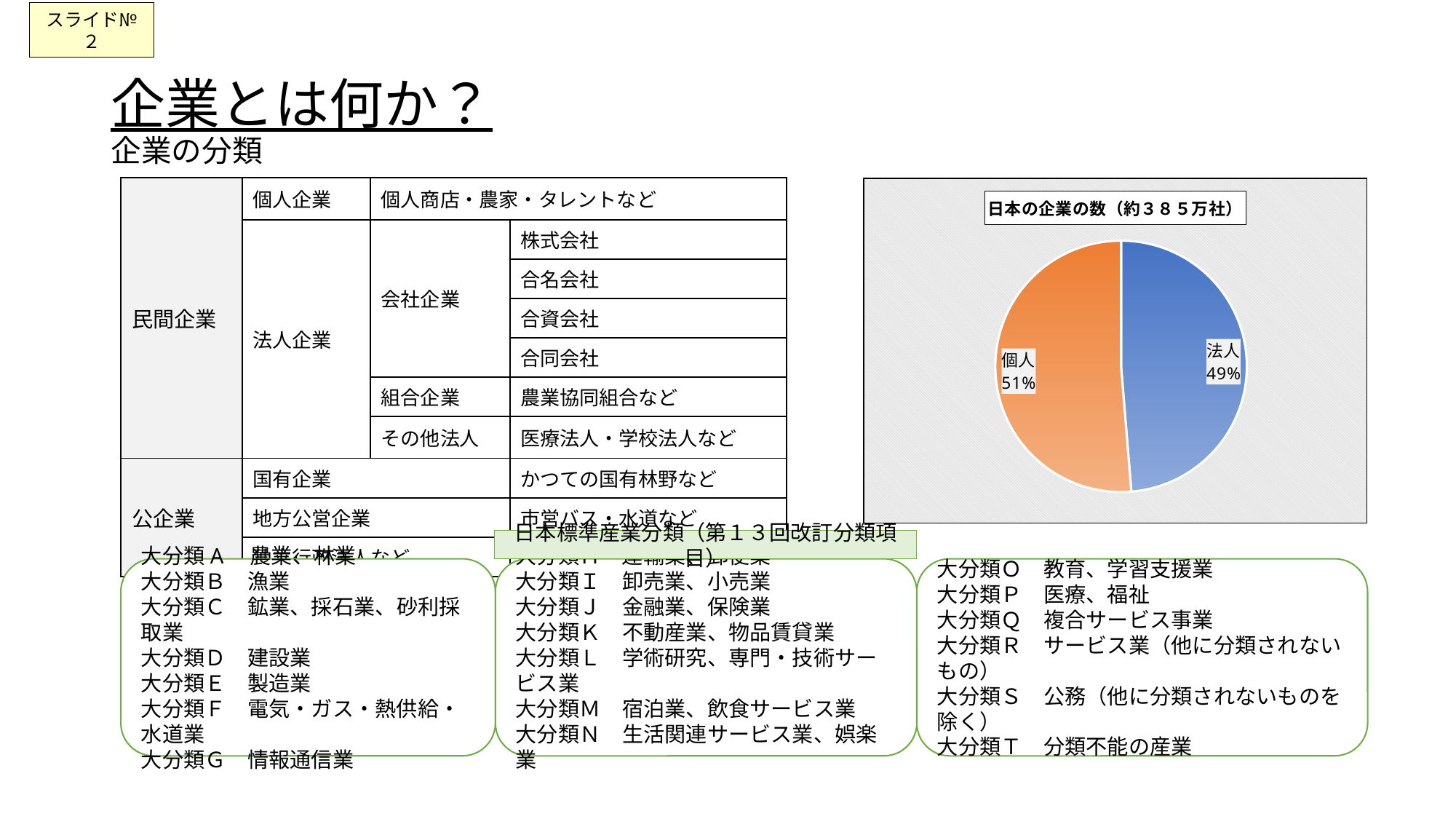
What share of the pie does 個人 represent? 51% Which slice of the pie chart is the smallest? 法人 What colour is the 法人 slice in the pie chart? blue Which is larger in the pie chart, 法人 or 個人? 個人 What share of the pie does 法人 represent? 49% Is the share for 個人 greater or less than 50%? greater What is the title of the pie chart? 日本の企業の数（約３８５万社） How many slices does the pie chart have? 2 Is the share for 法人 greater or less than 50%? less Which slice of the pie chart is the largest? 個人 What is the difference in percentage points between the 個人 slice and the 法人 slice? 2% What kind of chart is shown on the slide? pie chart